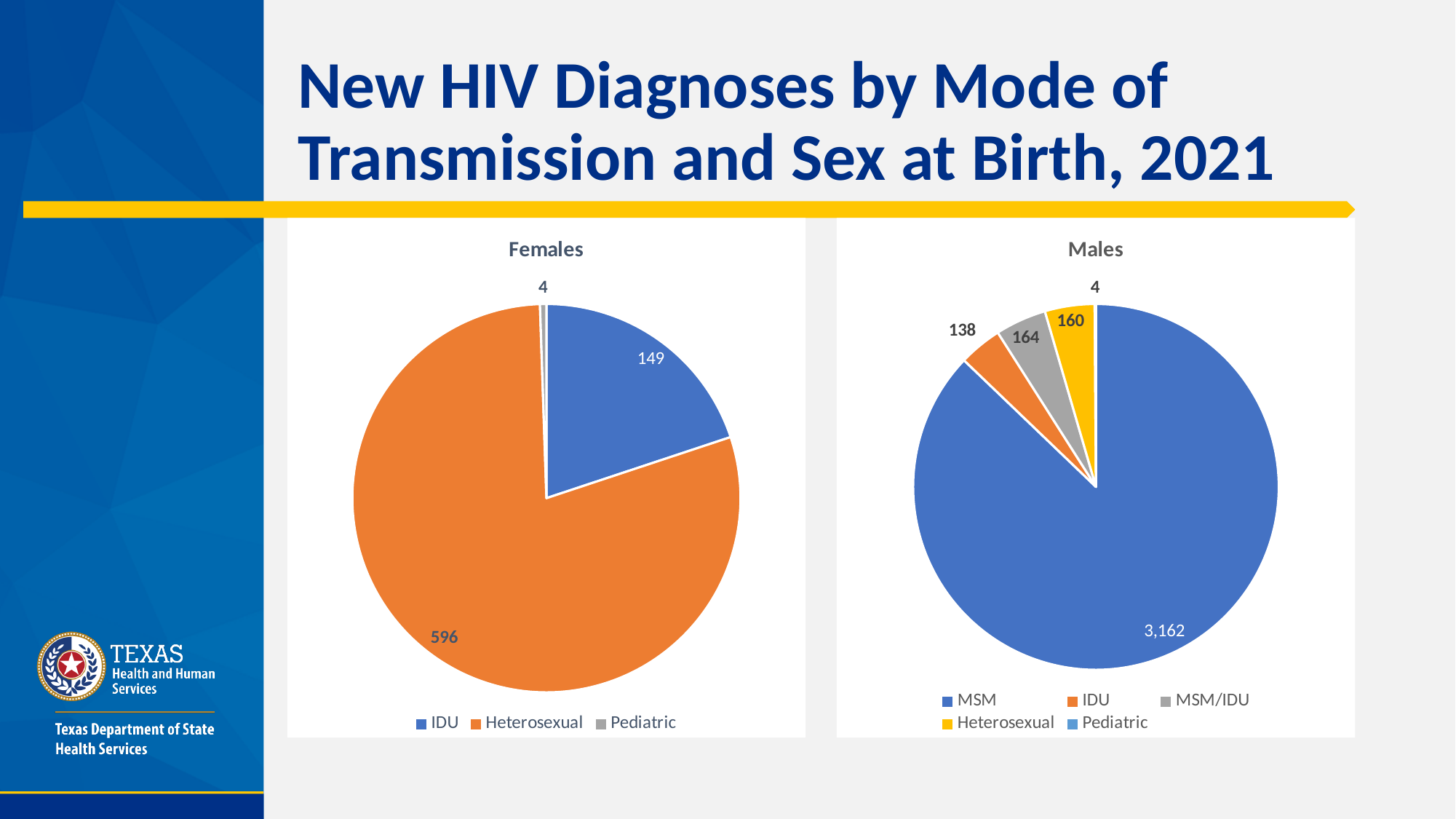
In the Males chart, which is larger, MSM/IDU or Heterosexual? MSM/IDU In the Males chart, which mode of transmission has the smallest slice? Pediatric In the Males chart, what is the value for MSM/IDU? 164 In the Females chart, what is the difference between the Heterosexual and IDU values? 447 In the Males chart, what is the difference between the MSM and IDU values? 3,024 In the Males chart, what is the value for MSM? 3,162 In the Females chart, what is the value for IDU? 149 How many slices does the Females chart have? 3 In the Females chart, which mode of transmission has the largest slice? Heterosexual How many categories does the legend of the Males chart list? 5 What type of chart is used for the Males data? Pie chart In the Females chart, how many new HIV diagnoses were attributed to Heterosexual transmission? 596